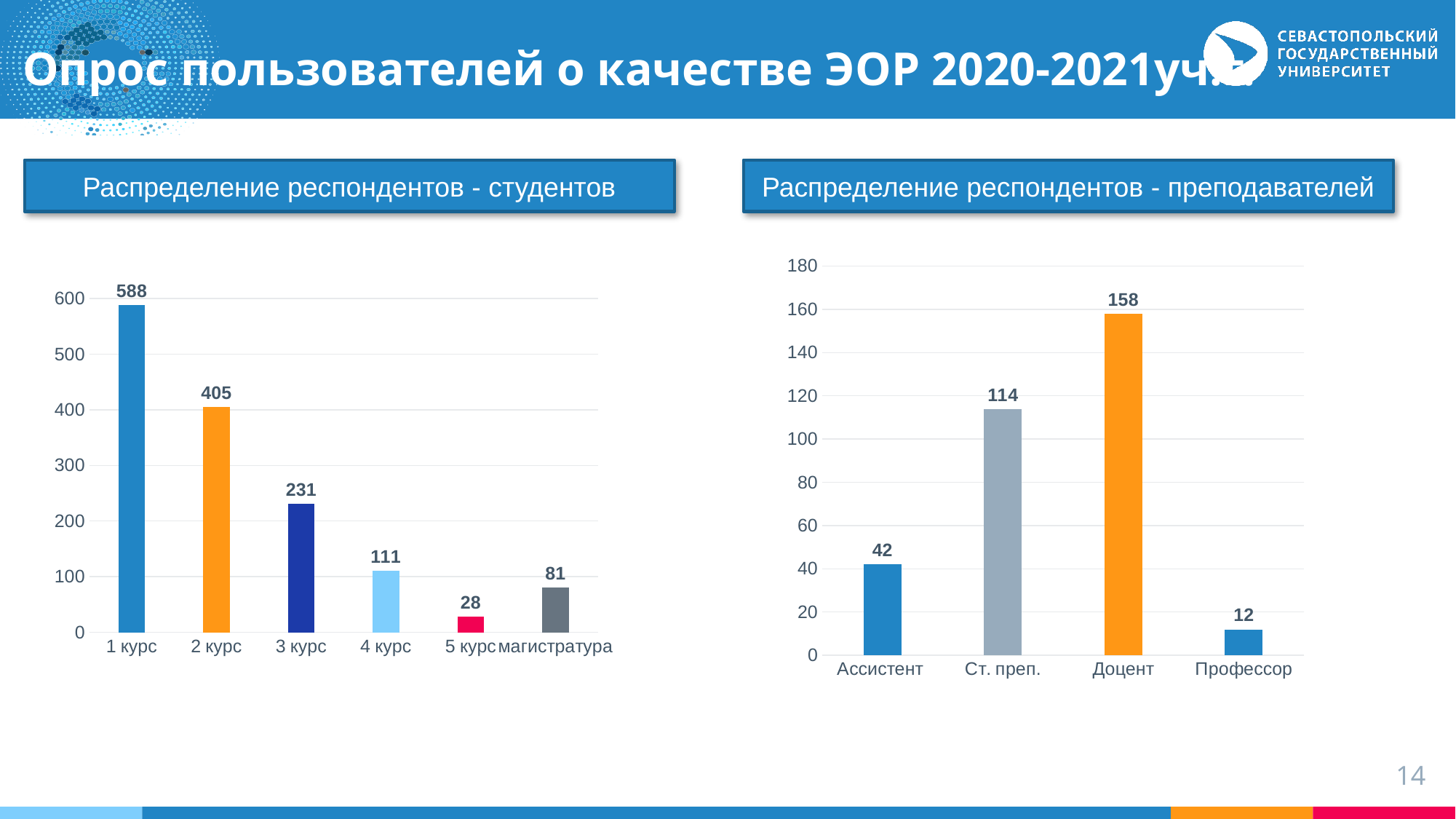
In the chart 'Распределение респондентов - преподавателей', what is the value for Ст. преп.? 114 In the chart 'Распределение респондентов - студентов', what is the value for 1 курс? 588 In the chart 'Распределение респондентов - студентов', what is the difference between the values for 1 курс and 2 курс? 183 What kind of chart is 'Распределение респондентов - преподавателей'? bar chart In the chart 'Распределение респондентов - студентов', what is the value for магистратура? 81 In the chart 'Распределение респондентов - преподавателей', what is the highest value shown on the y axis? 180 In the chart 'Распределение респондентов - преподавателей', which is larger, the value for Ассистент or the value for Профессор? Ассистент In the chart 'Распределение респондентов - студентов', which category has the lowest value? 5 курс In the chart 'Распределение респондентов - преподавателей', which category has the highest value? Доцент In the chart 'Распределение респондентов - студентов', do the values rise or fall from 1 курс to 5 курс? fall In the chart 'Распределение респондентов - студентов', how many categories are shown on the x axis? 6 In the chart 'Распределение респондентов - преподавателей', what is the difference between the values for Доцент and Ст. преп.? 44